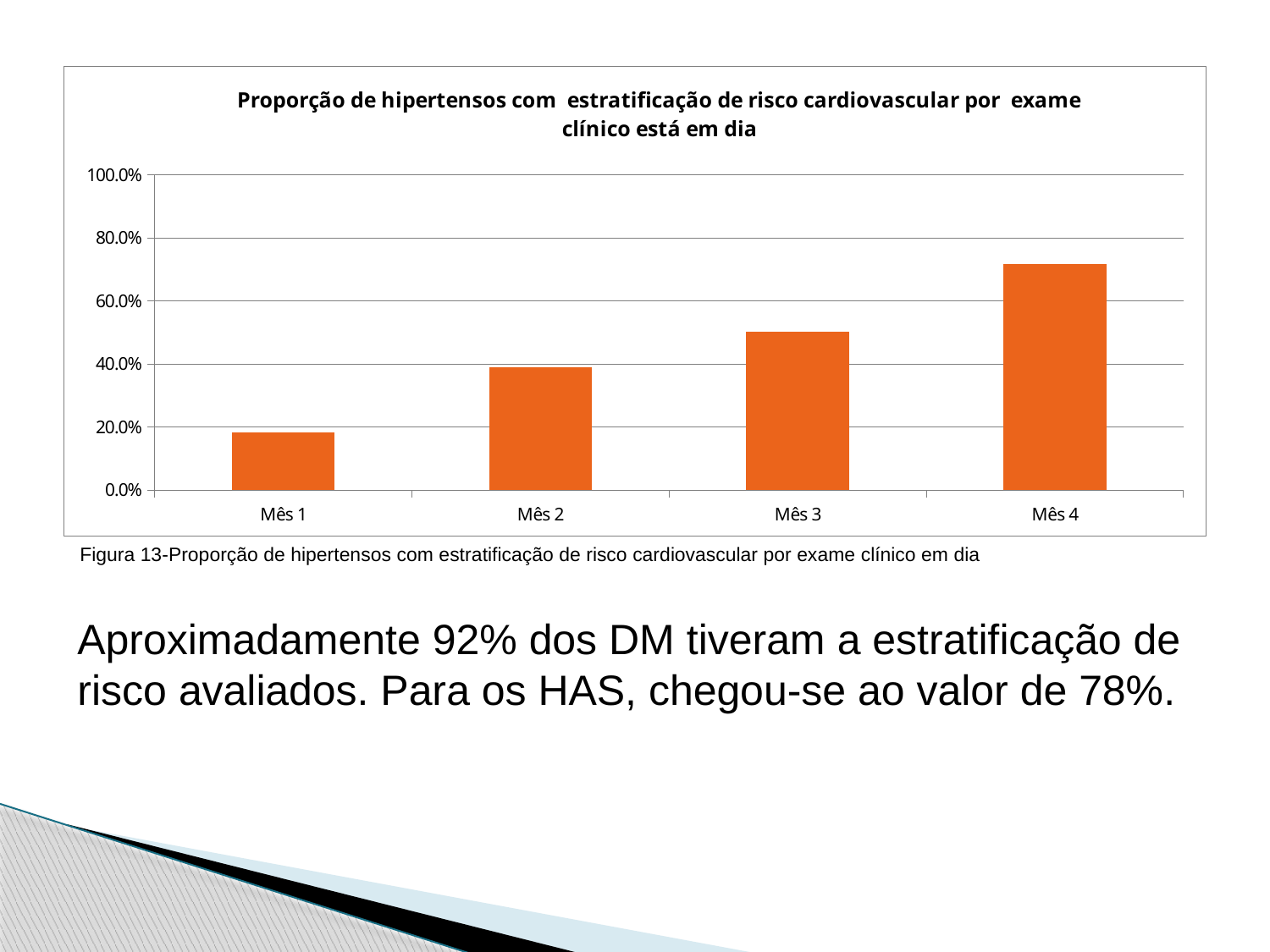
Which month has the highest value in the chart? Mês 4 Which is larger, the value for Mês 2 or the value for Mês 3? Mês 3 Is the value for Mês 4 greater or less than 60.0%? greater Do the values rise or fall from Mês 1 to Mês 4? rise What is the title of the chart? Proporção de hipertensos com estratificação de risco cardiovascular por exame clínico está em dia What kind of chart is shown on the slide? bar chart Is the value for Mês 1 greater or less than 20.0%? less Is the value for Mês 4 greater or less than 80.0%? less How many categories (months) are shown on the x axis of the chart? 4 Which month has the lowest value in the chart? Mês 1